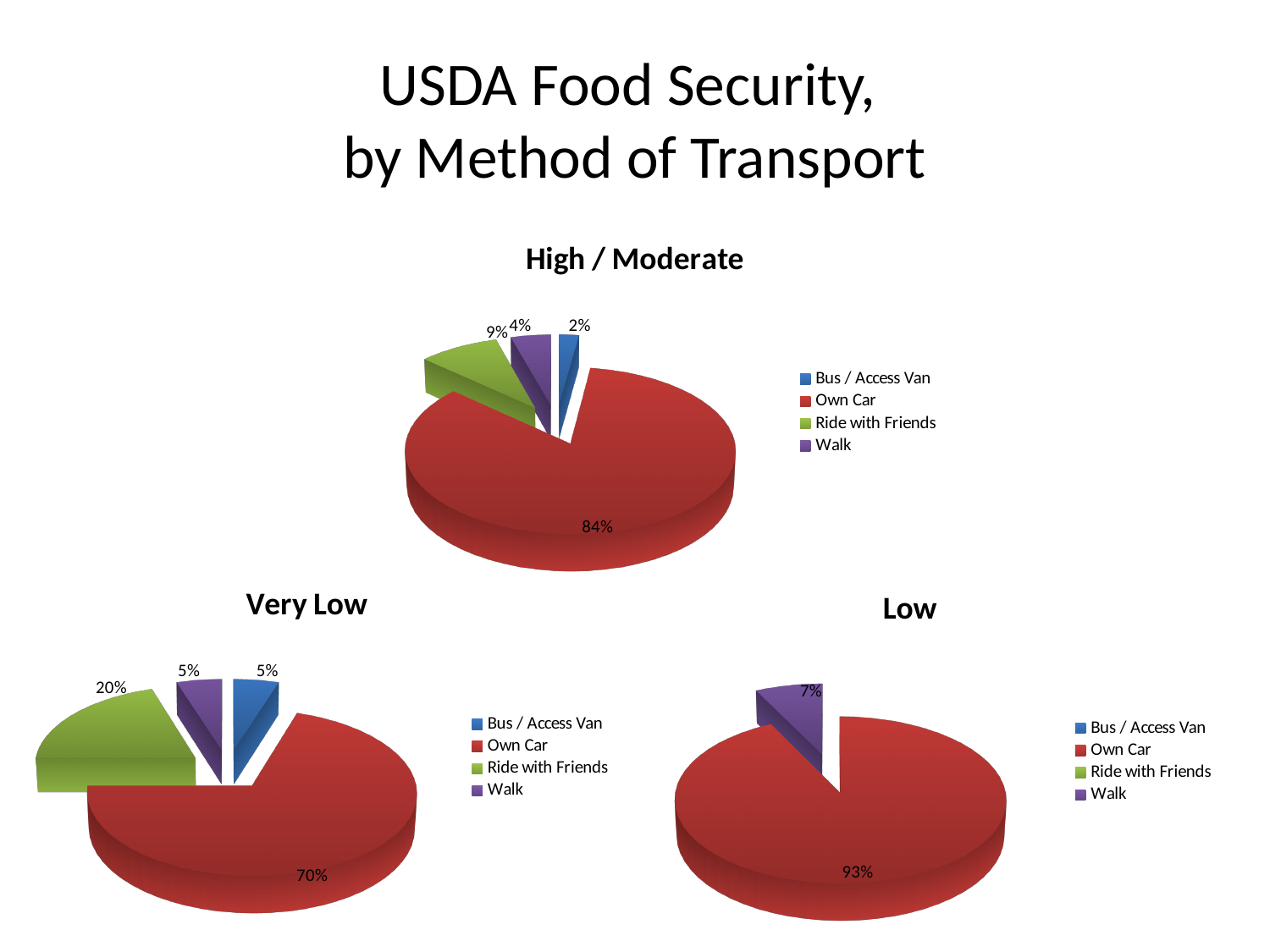
In the Very Low chart, what is the difference between the Own Car share and the Ride with Friends share? 50 percentage points Which is larger: the Walk share in the High / Moderate chart or the Walk share in the Low chart? Low In the Low chart, which category has the largest share? Own Car In the High / Moderate chart, what share is Ride with Friends? 9% In the Very Low chart, what share is Own Car? 70% In the High / Moderate chart, what share is Own Car? 84% How many series does the legend of the Very Low chart list? 4 In the High / Moderate chart, what share is Bus / Access Van? 2% In the Low chart, what share is Walk? 7% What kind of chart is the Low chart? Pie chart In the High / Moderate chart, which category has the smallest share? Bus / Access Van In the Very Low chart, what share is Ride with Friends? 20%